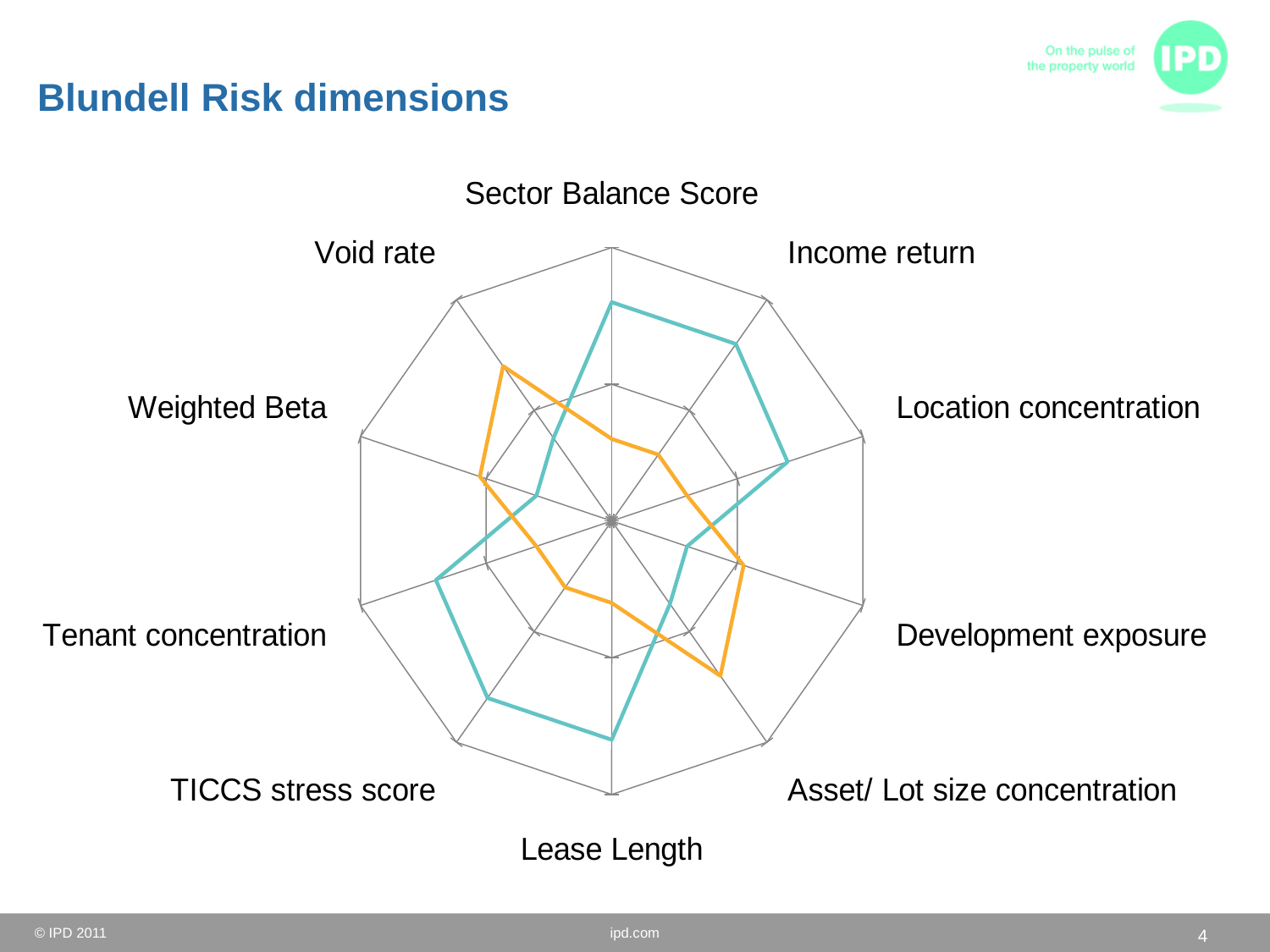
On the Development exposure axis, which line has the larger value, the teal line or the orange line? Orange On the Tenant concentration axis, which line has the larger value, the teal line or the orange line? Teal On the Asset/ Lot size concentration axis, which line has the larger value, the teal line or the orange line? Orange How many data series (lines) are plotted on the radar chart? 2 What is the title of the slide containing the radar chart? Blundell Risk dimensions What kind of chart is shown on the slide? Radar chart How many risk dimensions (axes) does the radar chart have? 10 Which risk dimension is labelled at the top of the radar chart? Sector Balance Score